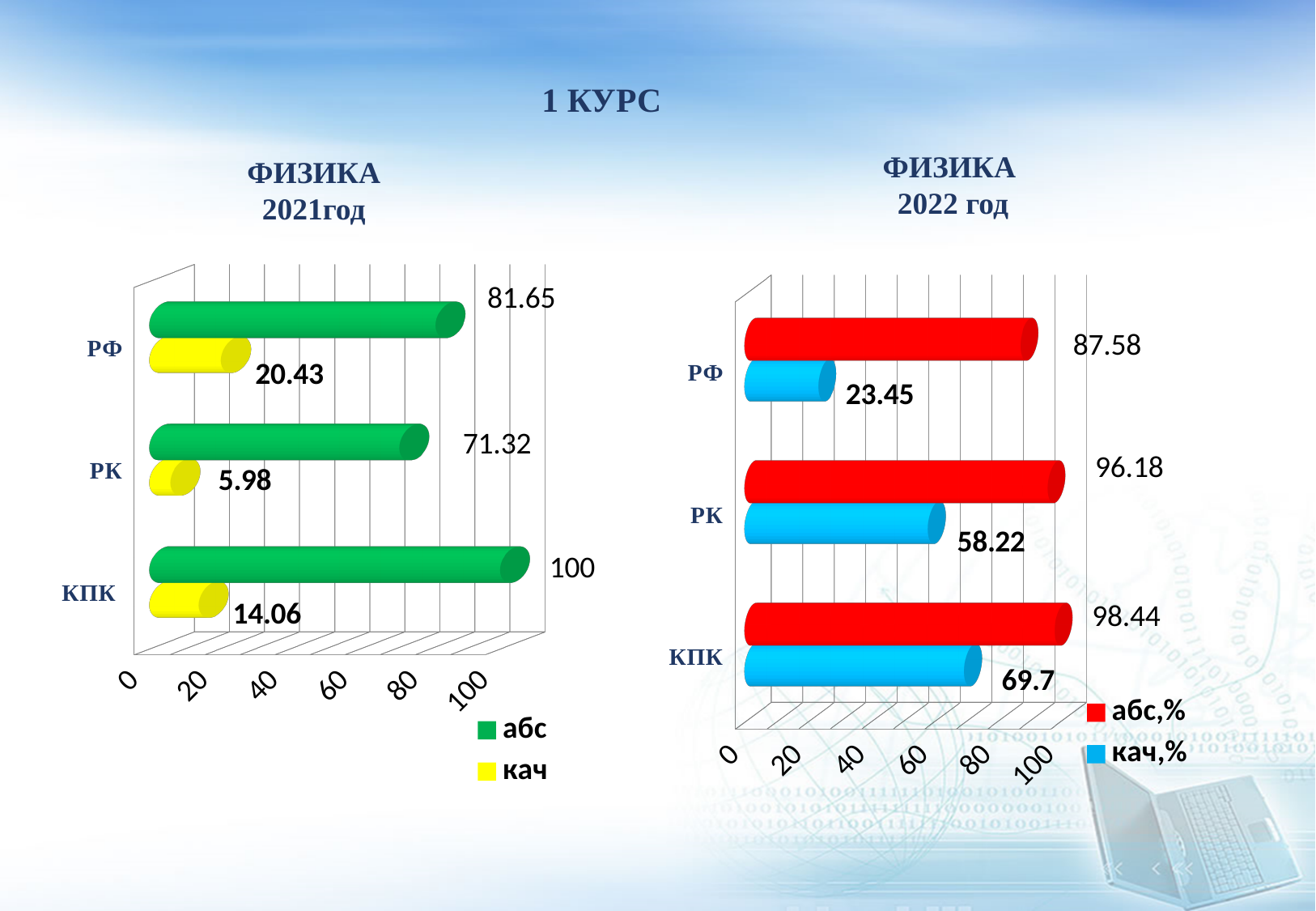
In the ФИЗИКА 2022 год chart, what is the difference between the абс,% and кач,% values for КПК? 28.74 In the ФИЗИКА 2021год chart, what is the кач value for РК? 5.98 In the ФИЗИКА 2021год chart, what is the абс value for РФ? 81.65 In the ФИЗИКА 2022 год chart, what is the абс,% value for РК? 96.18 In the ФИЗИКА 2022 год chart, what is the кач,% value for КПК? 69.7 In the ФИЗИКА 2022 год chart, what colour are the кач,% bars? blue What kind of chart is the ФИЗИКА 2022 год chart? bar chart In the ФИЗИКА 2022 год chart, which category has the lowest кач,% value? РФ How many categories are shown in the ФИЗИКА 2022 год chart? 3 In the ФИЗИКА 2021год chart, which is larger, the кач value for РФ or the кач value for КПК? РФ In the ФИЗИКА 2021год chart, which category has the highest абс value? КПК How many series does the legend of the ФИЗИКА 2021год chart list? 2